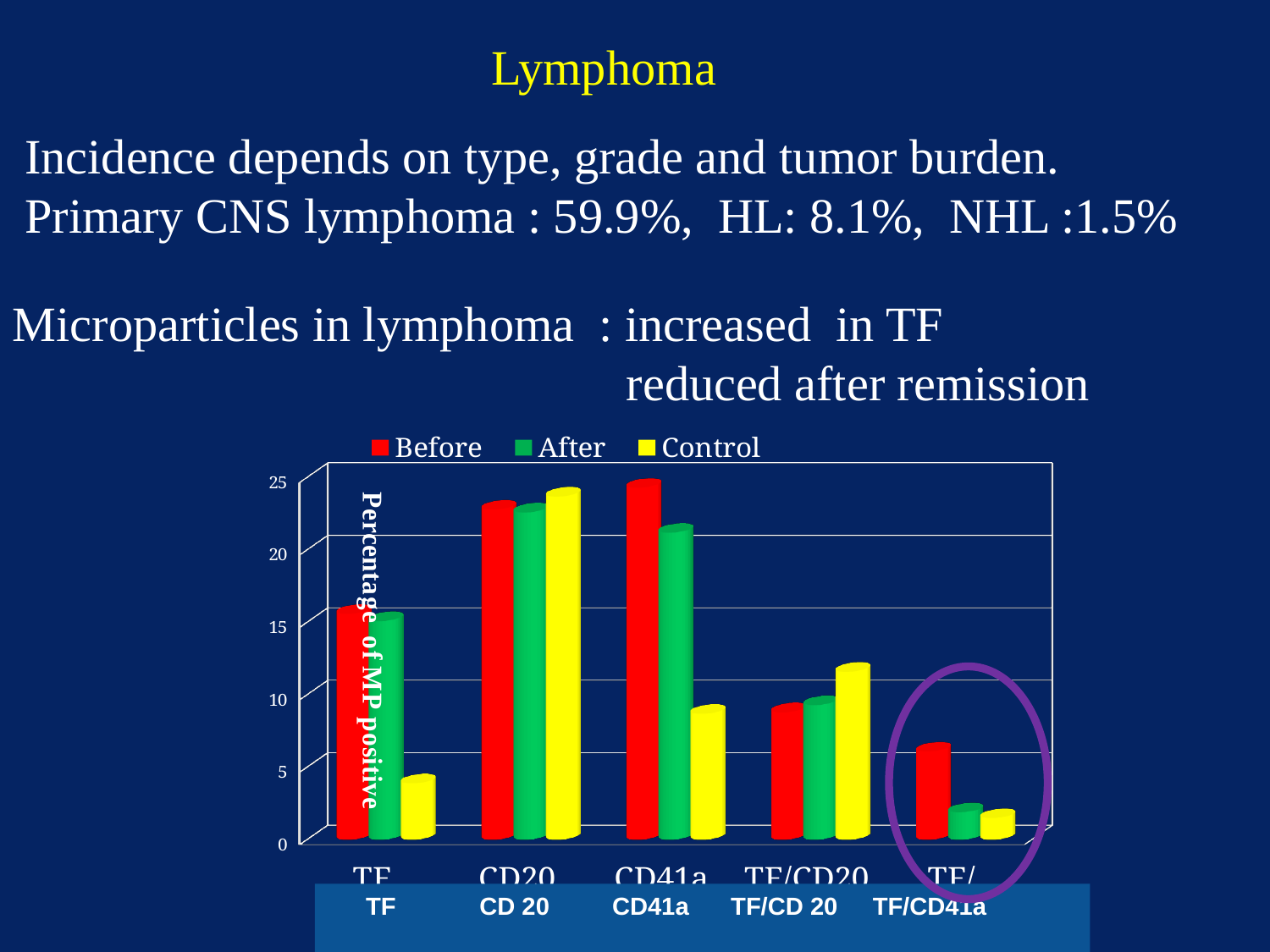
For TF, which is larger, the Before value or the Control value? Before Which category has the lowest Before value? TF/CD41a What are the three series named in the chart legend? Before, After, Control How many series does the chart legend list? 3 How many categories are shown on the x axis of the chart? 5 Is the After value for TF/CD41a greater or less than 5? less Which category has the highest Control value? CD 20 For TF/CD 20, which is larger, the Before value or the Control value? Control Which category has the lowest After value? TF/CD41a What is the label of the vertical axis of the chart? Percentage of MP positive What kind of chart is shown on the slide? bar chart Is the Control value for CD 20 greater or less than 20? greater